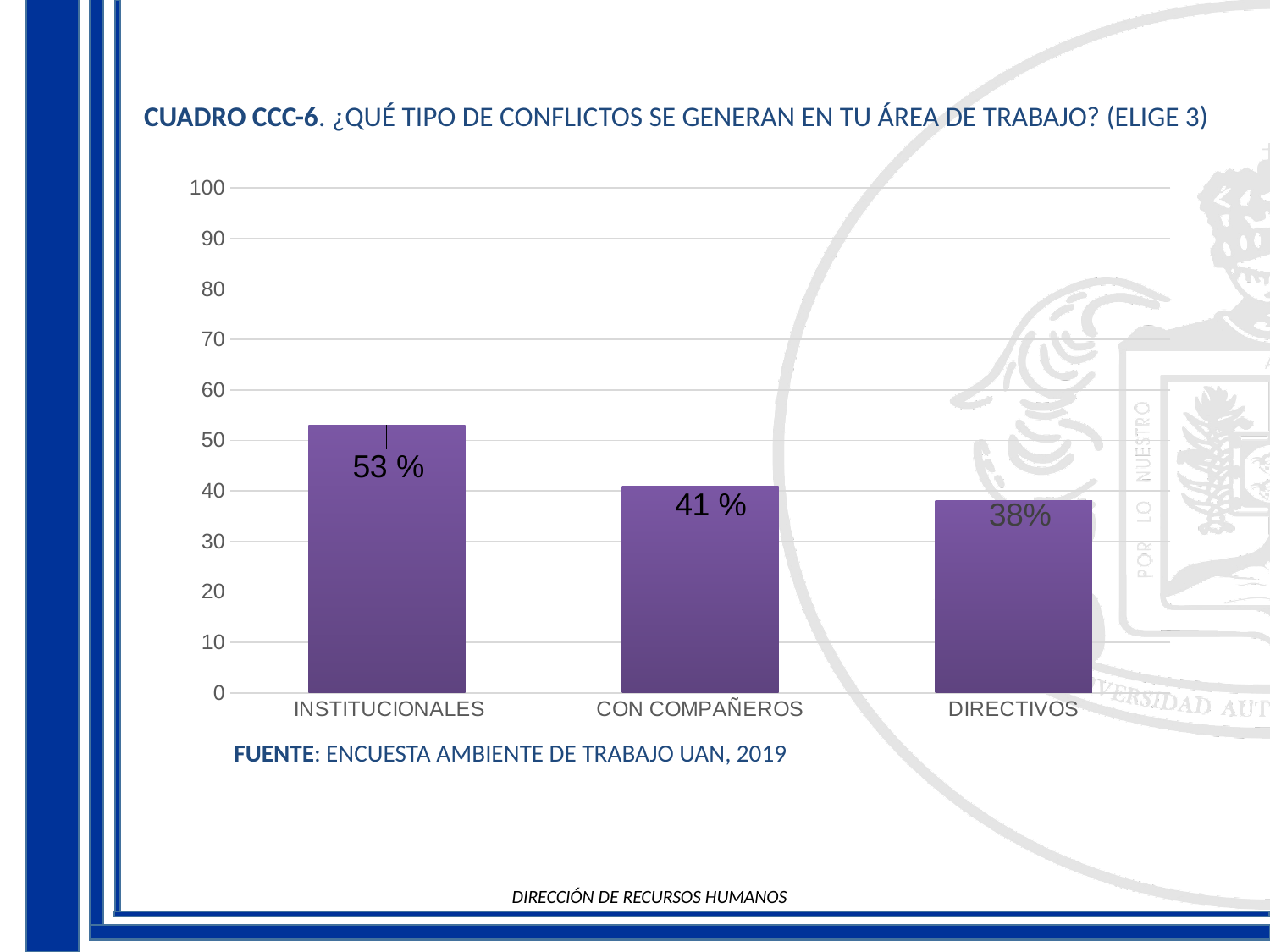
Do the values rise or fall from left to right along the x axis? fall How many categories are shown on the x axis? 3 What is the value for CON COMPAÑEROS? 41 % Which category has the lowest value? DIRECTIVOS Is the value for INSTITUCIONALES greater or less than 50? greater What is the difference between the values for INSTITUCIONALES and DIRECTIVOS? 15 What kind of chart is shown on the slide? bar chart What is the difference between the values for INSTITUCIONALES and CON COMPAÑEROS? 12 What is the value for INSTITUCIONALES? 53 % Which category has the highest value? INSTITUCIONALES Which is larger, the value for CON COMPAÑEROS or the value for DIRECTIVOS? CON COMPAÑEROS What is the value for DIRECTIVOS? 38%